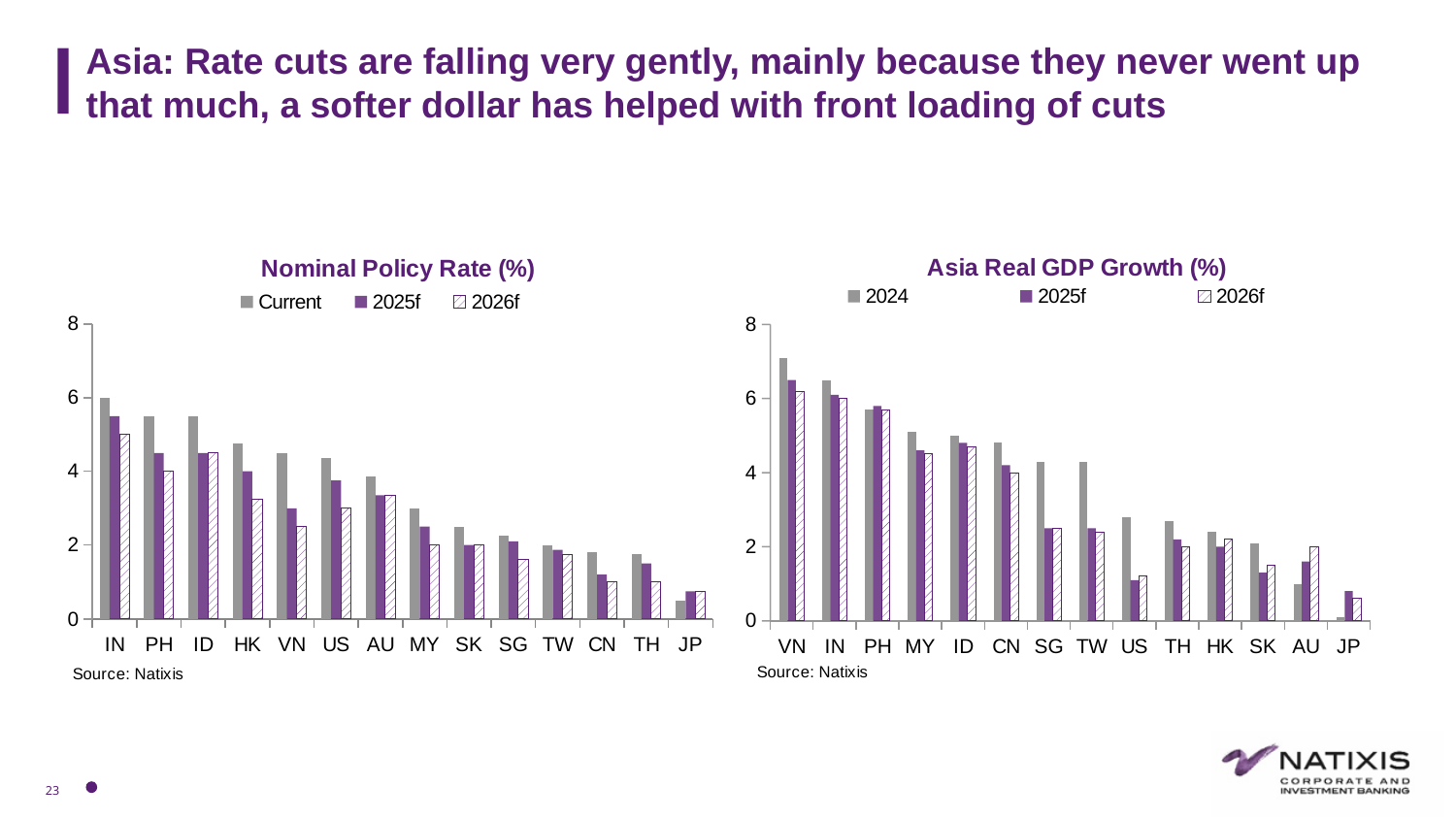
In the Asia Real GDP Growth (%) chart, which economy has the highest 2024 growth? VN In the Nominal Policy Rate (%) chart, which economy has the highest Current policy rate? IN How many series does the legend of the Asia Real GDP Growth (%) chart list? 3 In the Nominal Policy Rate (%) chart, is the 2026f value for HK greater or less than 2? greater In the Nominal Policy Rate (%) chart, do the Current values rise or fall moving from IN on the left to JP on the right? fall What kind of chart is the Nominal Policy Rate (%) chart? bar chart In the Asia Real GDP Growth (%) chart, is the 2025f value for US greater or less than 2? less How many economies are shown on the x axis of the Nominal Policy Rate (%) chart? 14 In the Nominal Policy Rate (%) chart, which economy has the lowest Current policy rate? JP In the Nominal Policy Rate (%) chart, is the Current value for IN greater or less than 4? greater In the Asia Real GDP Growth (%) chart, which is larger for AU: the 2024 value or the 2026f value? 2026f In the Asia Real GDP Growth (%) chart, which economy has the lowest 2024 growth? JP